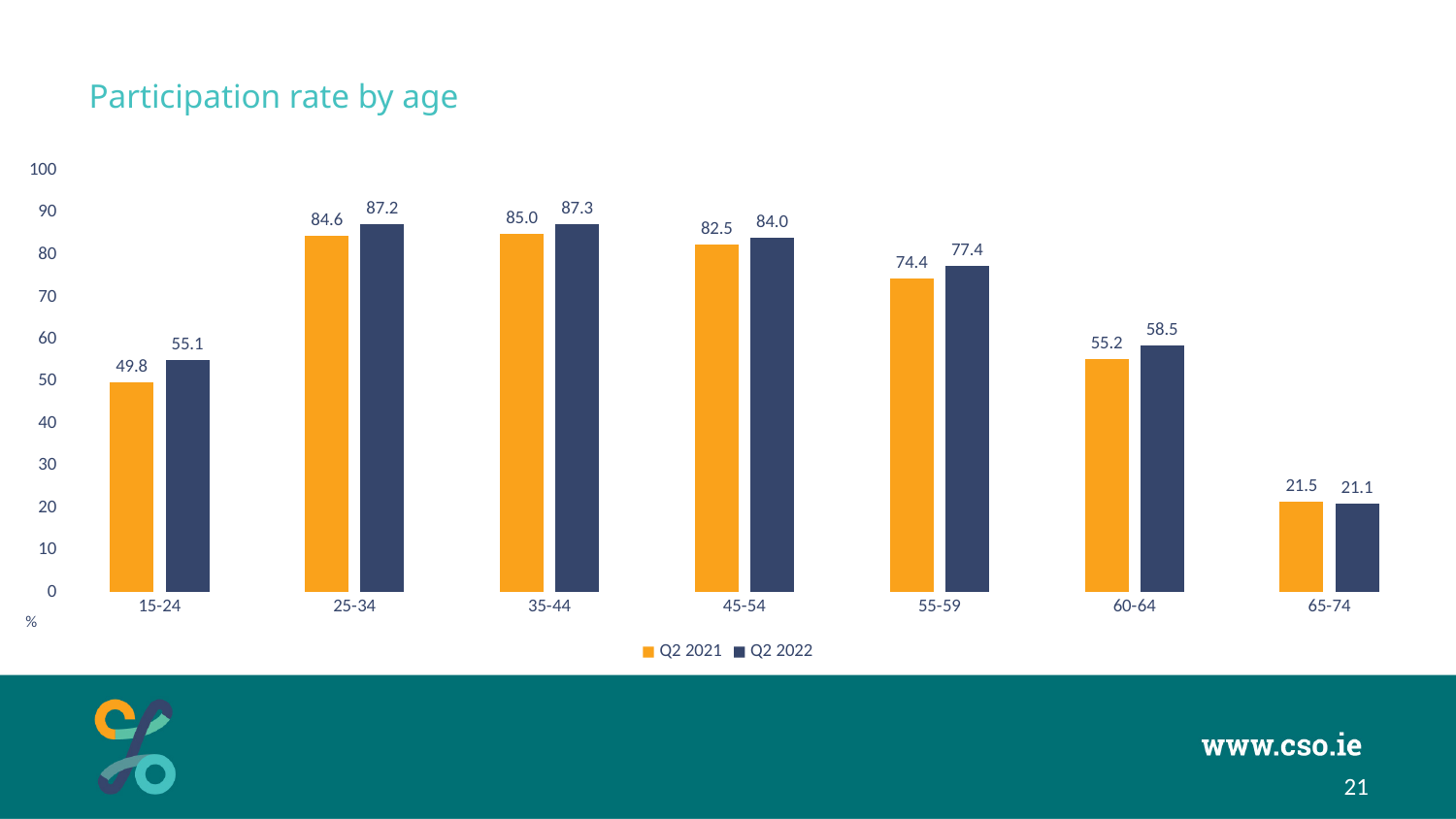
Which colour represents Q2 2021 in the chart? orange How many age groups are shown on the x axis? 7 What is the participation rate for the 55-59 age group in Q2 2021? 74.4 How many series does the legend list? 2 Which age group has the lowest participation rate in Q2 2021? 65-74 What is the title of the chart? Participation rate by age What is the difference between the Q2 2022 and Q2 2021 participation rates for the 15-24 age group? 5.3 Which is larger for the 65-74 age group: the Q2 2021 value or the Q2 2022 value? Q2 2021 What is the participation rate for the 15-24 age group in Q2 2022? 55.1 Which age group has the highest participation rate in Q2 2022? 35-44 What kind of chart is shown on the slide? bar chart Is the Q2 2022 participation rate for the 60-64 age group greater or less than 50? greater